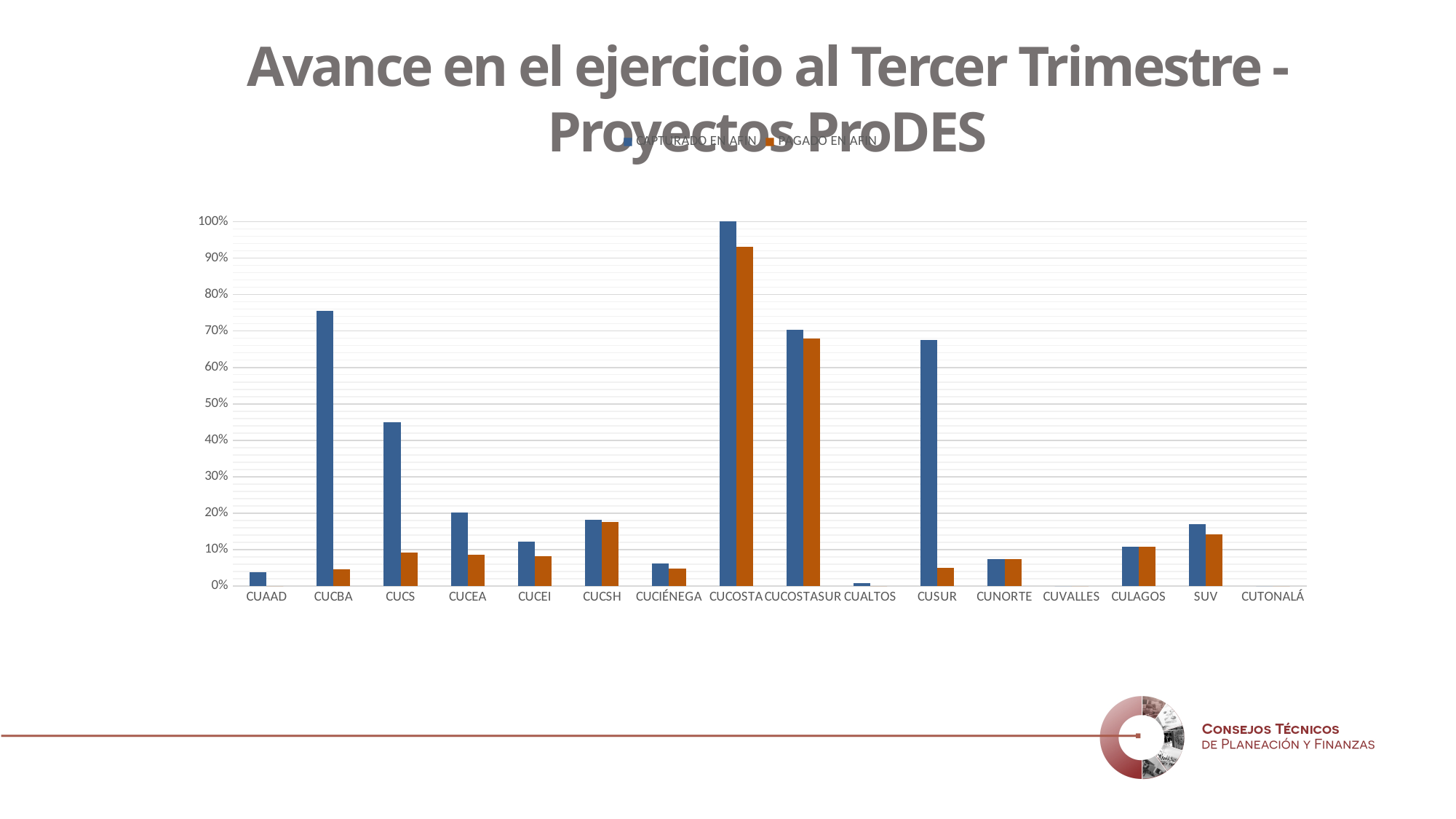
Is the blue bar for CUCEA greater or less than 10%? greater How many categories are shown along the x axis of the chart? 16 What kind of chart is shown on the slide? bar chart Is the blue bar for CUCBA greater or less than 70%? greater How many series does the chart's legend list? 2 Which has the larger blue bar, CUCBA or CUSUR? CUCBA Is the blue bar for CUCS greater or less than 40%? greater Which category has the highest blue bar? CUCOSTA Which category has the highest orange bar? CUCOSTA What is the title of the chart on the slide? Avance en el ejercicio al Tercer Trimestre - Proyectos ProDES